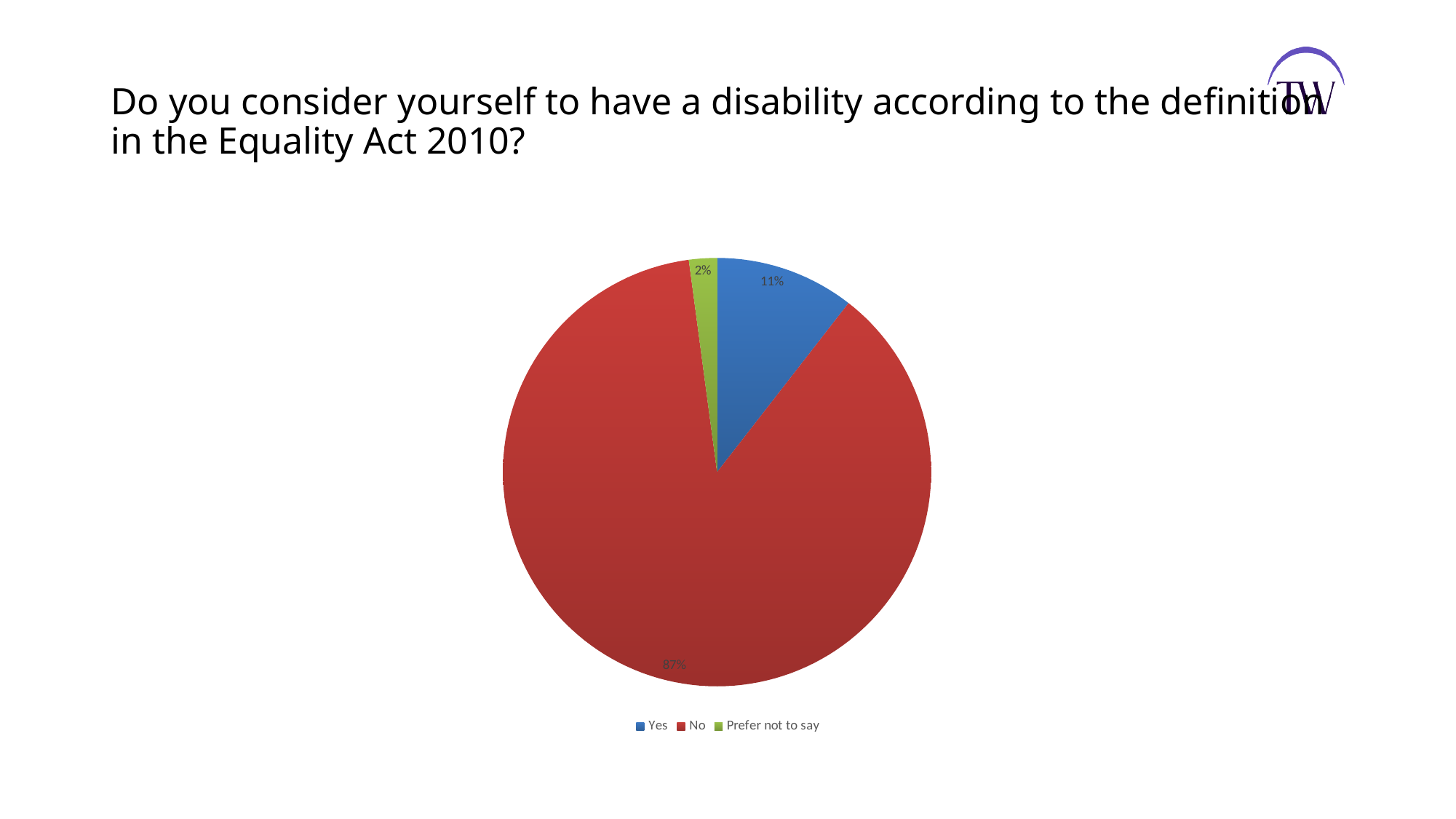
What share of respondents answered "Prefer not to say"? 2% What is the difference in percentage points between the "No" and "Yes" slices? 76 What kind of chart is shown on the slide? pie chart What colour is the "No" slice? red What share of respondents answered "Yes"? 11% Which is larger, the "Yes" slice or the "Prefer not to say" slice? Yes What share of respondents answered "No"? 87% How many slices does the pie chart have? 3 What is the title of the chart on the slide? Do you consider yourself to have a disability according to the definition in the Equality Act 2010? What is the difference in percentage points between the "Yes" and "Prefer not to say" slices? 9 Which response has the smallest slice of the pie? Prefer not to say Which response has the largest slice of the pie? No